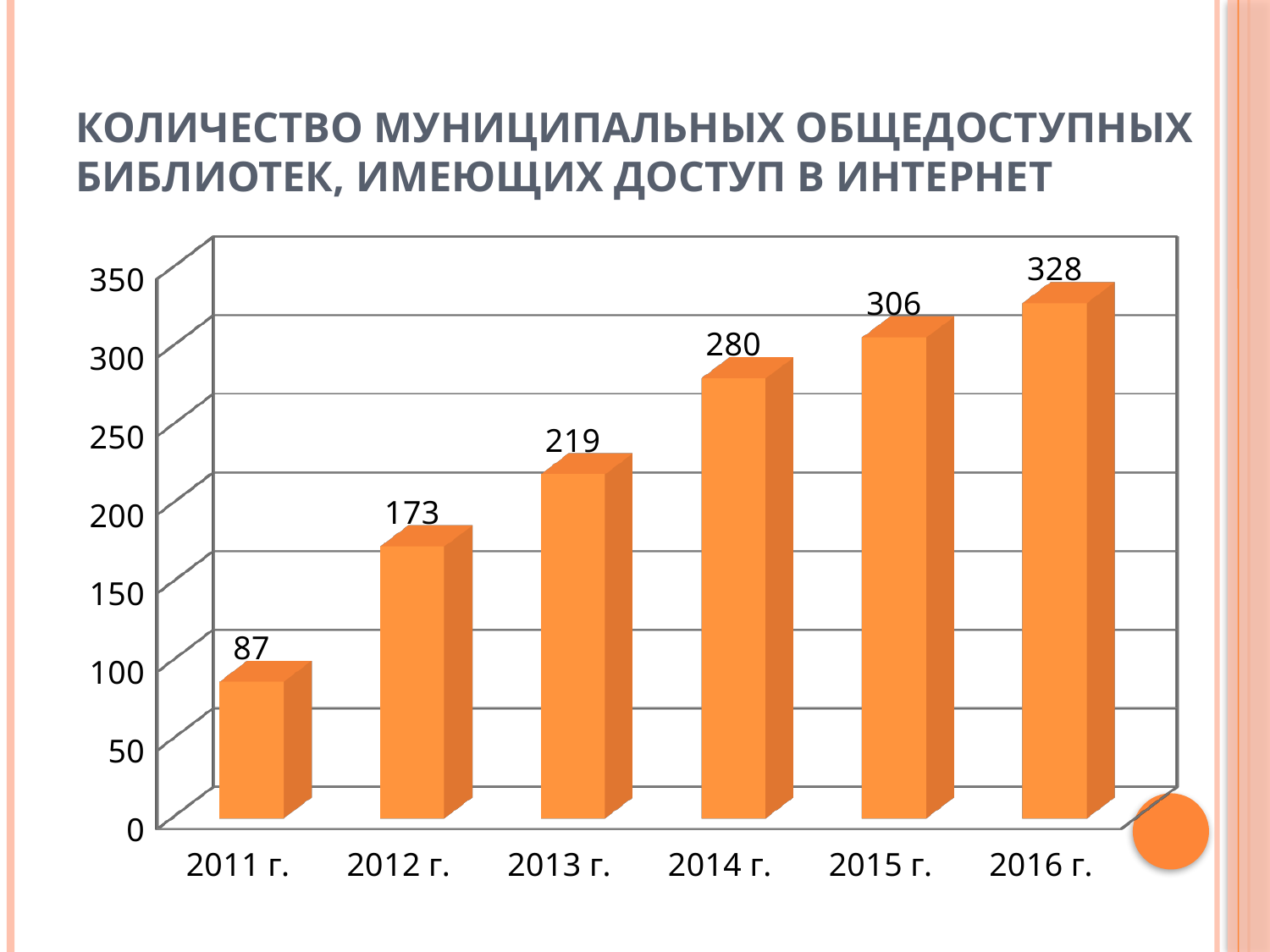
How many years are shown on the x axis? 6 What kind of chart is shown on the slide? bar chart What is the difference between the values for 2016 г. and 2015 г.? 22 Which year has the lowest value? 2011 г. What is the value for 2016 г.? 328 Which is larger, the value for 2013 г. or the value for 2014 г.? 2014 г. Is the value for 2015 г. greater or less than 300? greater What is the difference between the values for 2012 г. and 2011 г.? 86 Which year has the highest value? 2016 г. What is the value for 2011 г.? 87 What is the value for 2014 г.? 280 Do the values rise or fall from 2011 г. to 2016 г.? rise